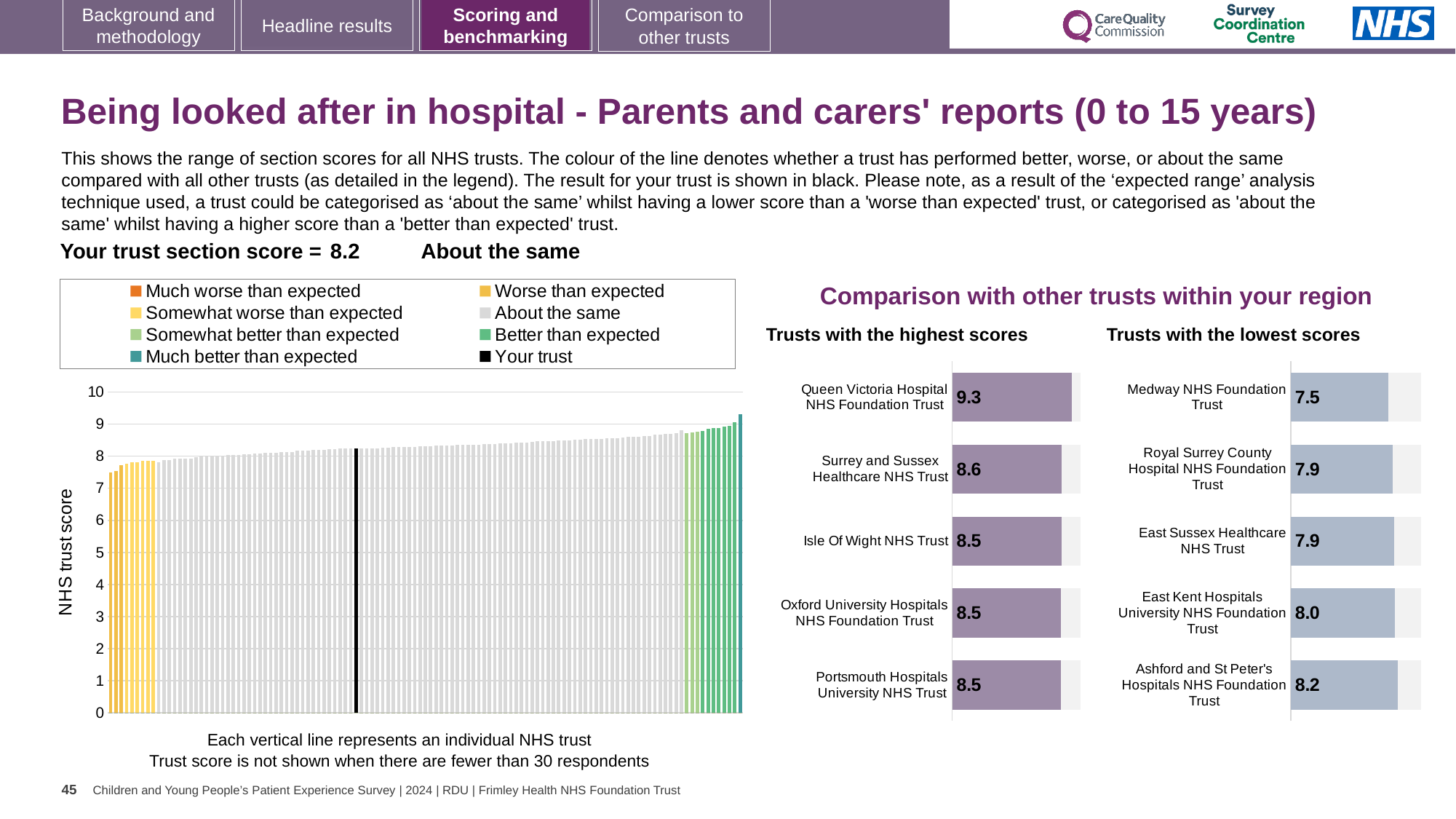
In the 'Trusts with the highest scores' chart, what is the score for Queen Victoria Hospital NHS Foundation Trust? 9.3 In the 'Trusts with the lowest scores' chart, which trust has the lowest score? Medway NHS Foundation Trust In the 'Trusts with the highest scores' chart, which trust has the highest score? Queen Victoria Hospital NHS Foundation Trust In the 'Trusts with the lowest scores' chart, what is the score for Ashford and St Peter's Hospitals NHS Foundation Trust? 8.2 What is the label on the vertical axis of the large chart on the left? NHS trust score In the large chart on the left, do the trust scores rise or fall from left to right? Rise What kind of chart is the large chart on the left showing all NHS trusts? Bar chart How many trusts are listed in the 'Trusts with the highest scores' chart? 5 In the 'Trusts with the lowest scores' chart, which has the larger score: Royal Surrey County Hospital NHS Foundation Trust or East Kent Hospitals University NHS Foundation Trust? East Kent Hospitals University NHS Foundation Trust In the 'Trusts with the lowest scores' chart, what is the score for Medway NHS Foundation Trust? 7.5 How many entries does the legend above the large chart on the left list? 8 In the 'Trusts with the highest scores' chart, what is the difference between the scores of Queen Victoria Hospital NHS Foundation Trust and Surrey and Sussex Healthcare NHS Trust? 0.7